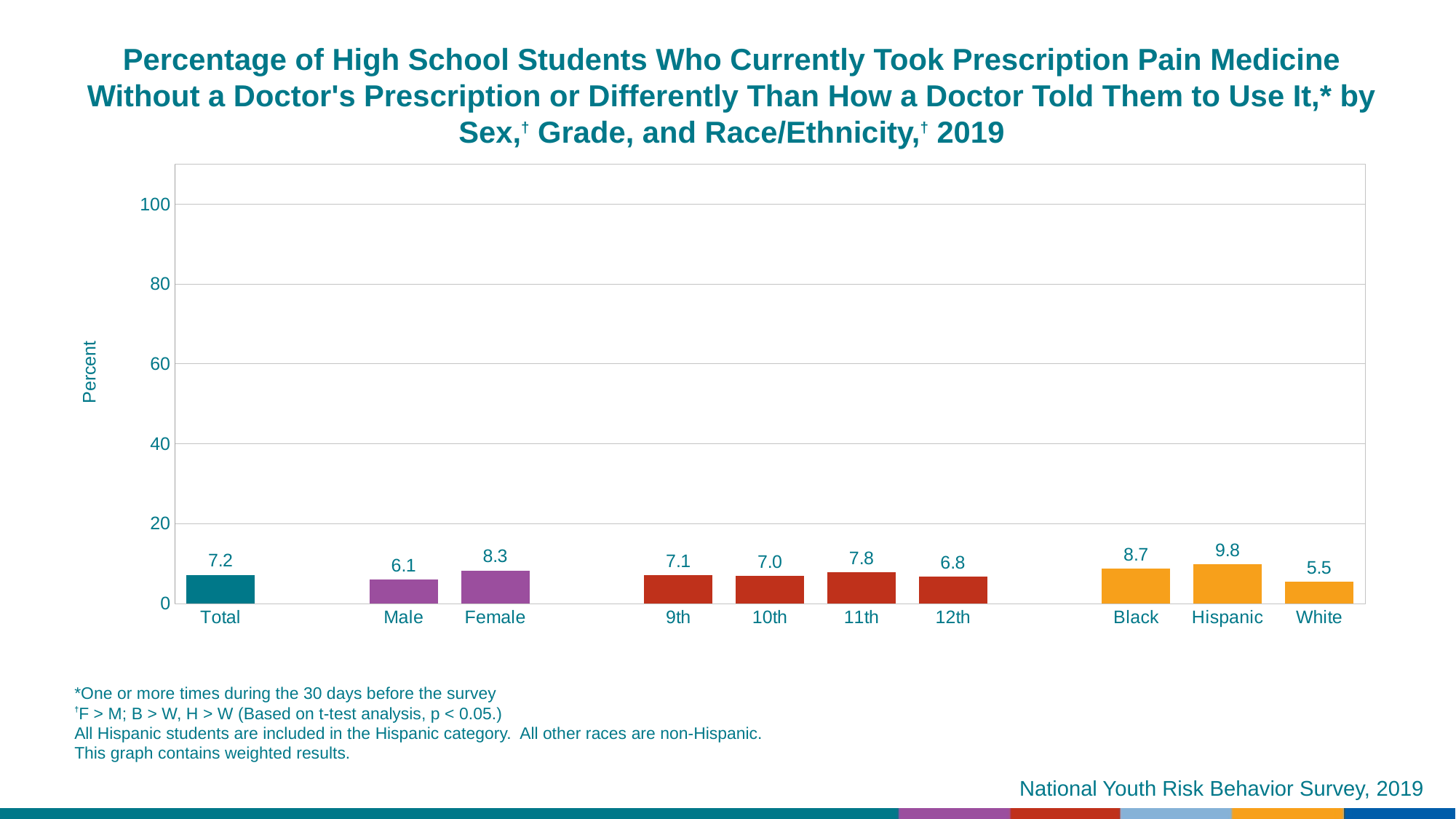
What is the value for 11th grade? 7.8 What is the label of the y axis? Percent What is the value for Female? 8.3 How many categories are shown on the x axis? 10 What is the difference between the Female and Male values? 2.2 Which category has the lowest value? White Is the value for 12th grade greater or less than 20? less What is the value for Total? 7.2 Which is larger, the value for Black or the value for White? Black Which category has the highest value? Hispanic What kind of chart is this? bar chart What is the value for Hispanic? 9.8